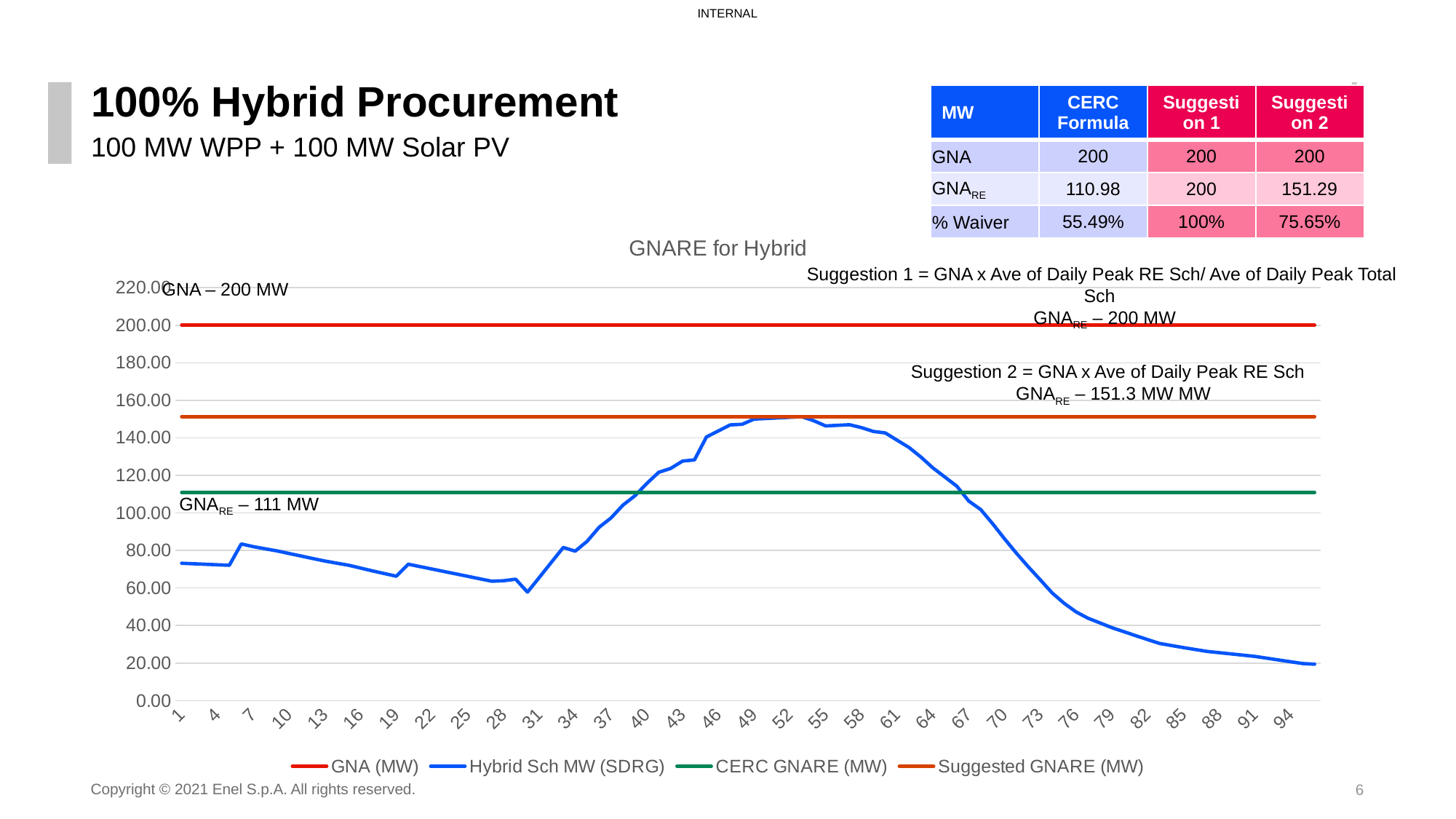
What value does the GNA (MW) line sit at, according to the annotation on the chart? 200 MW What is the title of the chart? GNARE for Hybrid Is the value of the Hybrid Sch MW (SDRG) line at point 94 greater or less than 40? less Does the Hybrid Sch MW (SDRG) line rise or fall between point 52 and point 94? fall How many series does the chart legend list? 4 What value does the Suggested GNARE (MW) line sit at, according to the annotation on the chart? 151.3 MW What value does the CERC GNARE (MW) line sit at, according to the annotation on the chart? 111 MW Which of the horizontal lines in the chart is the lowest? CERC GNARE (MW) Which of the horizontal lines in the chart is the highest? GNA (MW) What is the difference between the GNA line (200 MW) and the CERC GNARE line (111 MW)? 89 MW Which is larger, the Suggested GNARE (MW) line or the CERC GNARE (MW) line? Suggested GNARE (MW) What kind of chart is shown on the slide? line chart